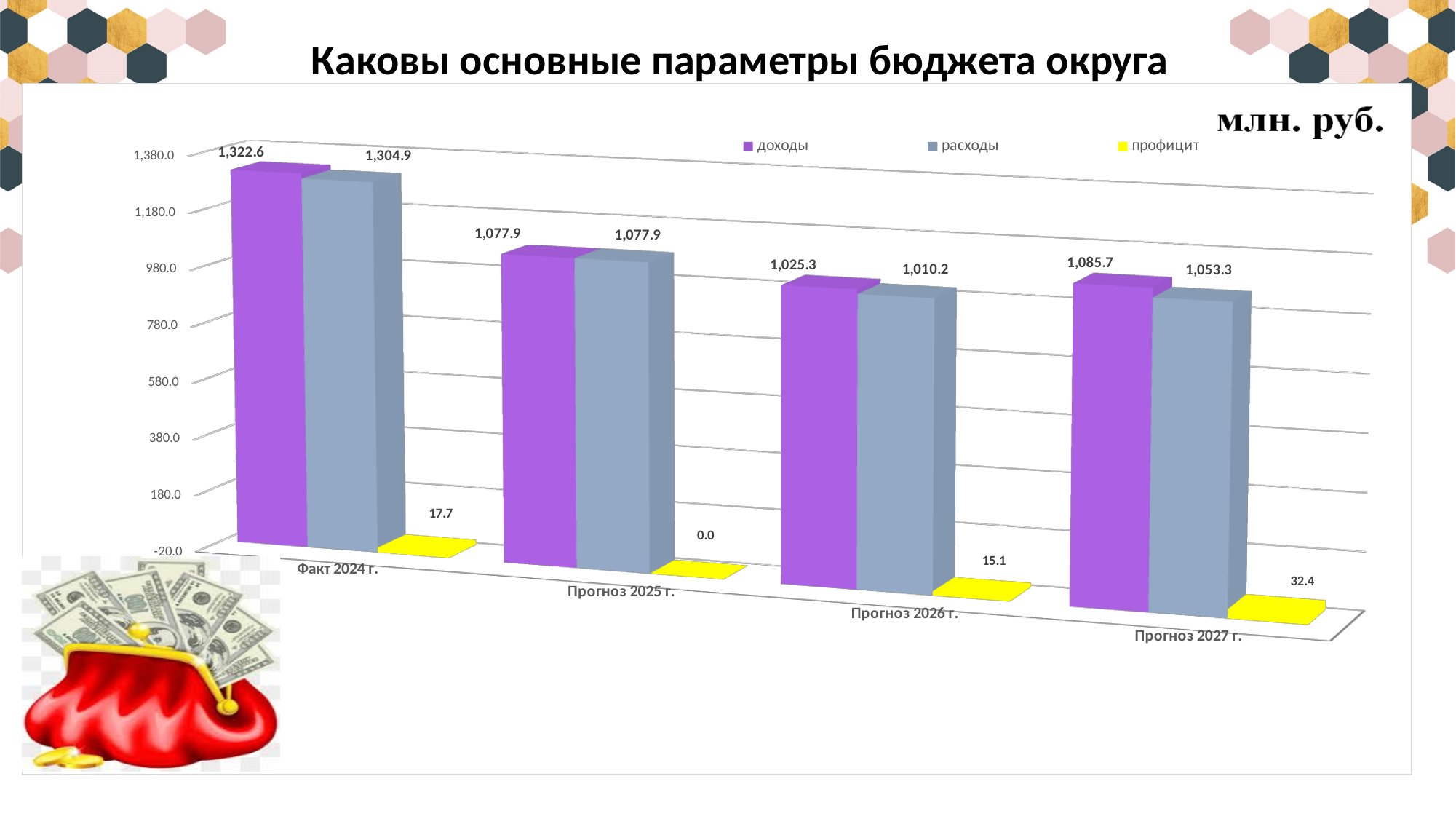
What is the value of профицит for Прогноз 2026 г.? 15.1 What is the value of доходы for Факт 2024 г.? 1,322.6 What unit is indicated in the top right corner of the chart? млн. руб. In which category is профицит the lowest? Прогноз 2025 г. How many categories are shown on the x axis? 4 What is the value of расходы for Прогноз 2027 г.? 1,053.3 What is the value of профицит for Прогноз 2025 г.? 0.0 How many series does the legend list? 3 In which category is доходы the highest? Факт 2024 г. Which is larger for Прогноз 2026 г.: доходы or расходы? доходы What is the difference between доходы and расходы for Прогноз 2027 г.? 32.4 What kind of chart is shown on the slide? bar chart